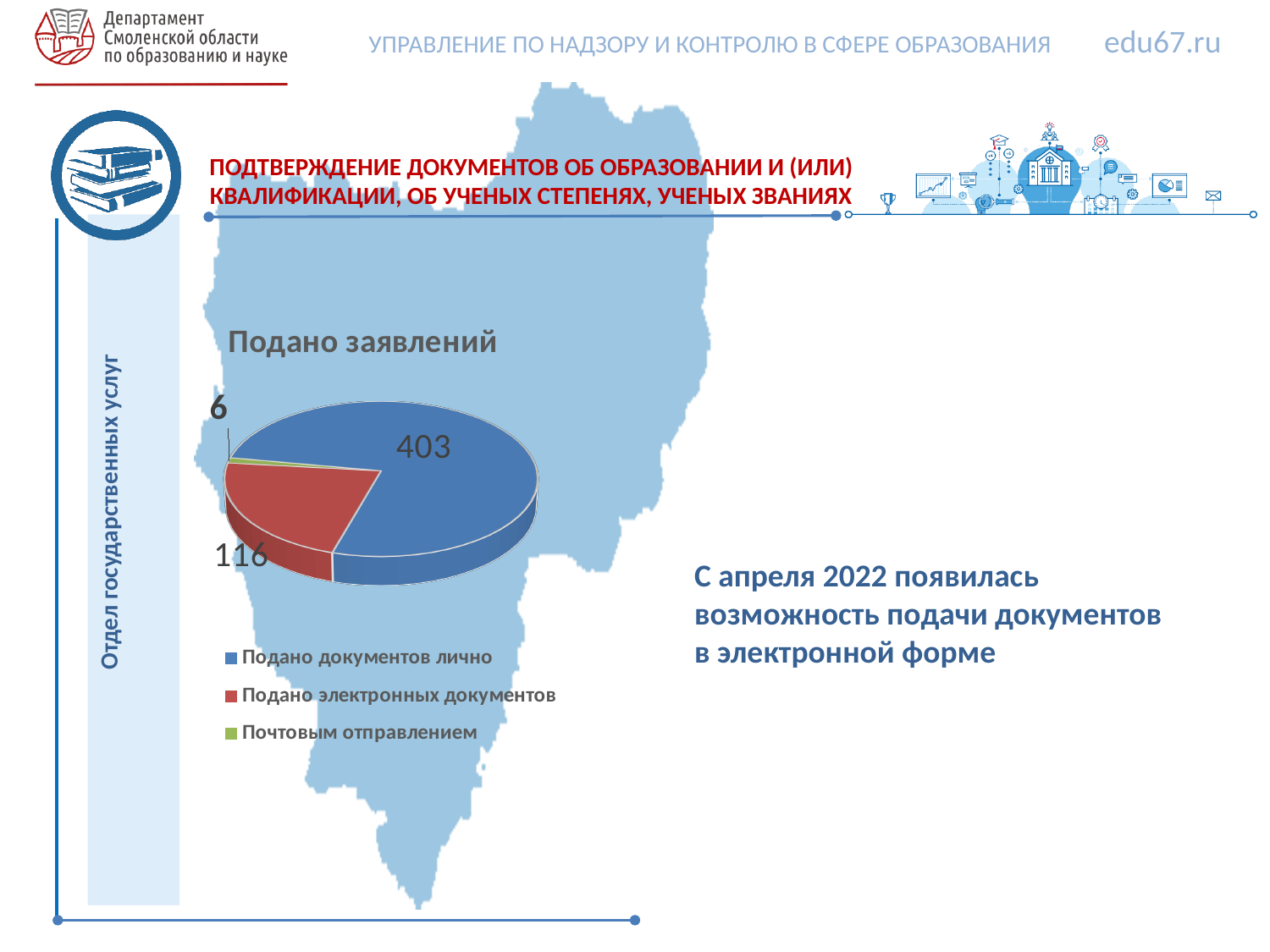
What is the value for "Подано электронных документов"? 116 What is the value for "Почтовым отправлением"? 6 Which is larger: "Подано электронных документов" or "Почтовым отправлением"? Подано электронных документов What type of chart is shown on the slide? pie chart What is the total of all three slices in the pie chart? 525 What is the value for "Подано документов лично"? 403 Which category has the smallest slice of the pie? Почтовым отправлением What is the difference between the values for "Подано документов лично" and "Подано электронных документов"? 287 How many entries does the chart legend list? 3 What is the title of the chart? Подано заявлений Which category has the largest slice of the pie? Подано документов лично How many slices does the pie chart have? 3